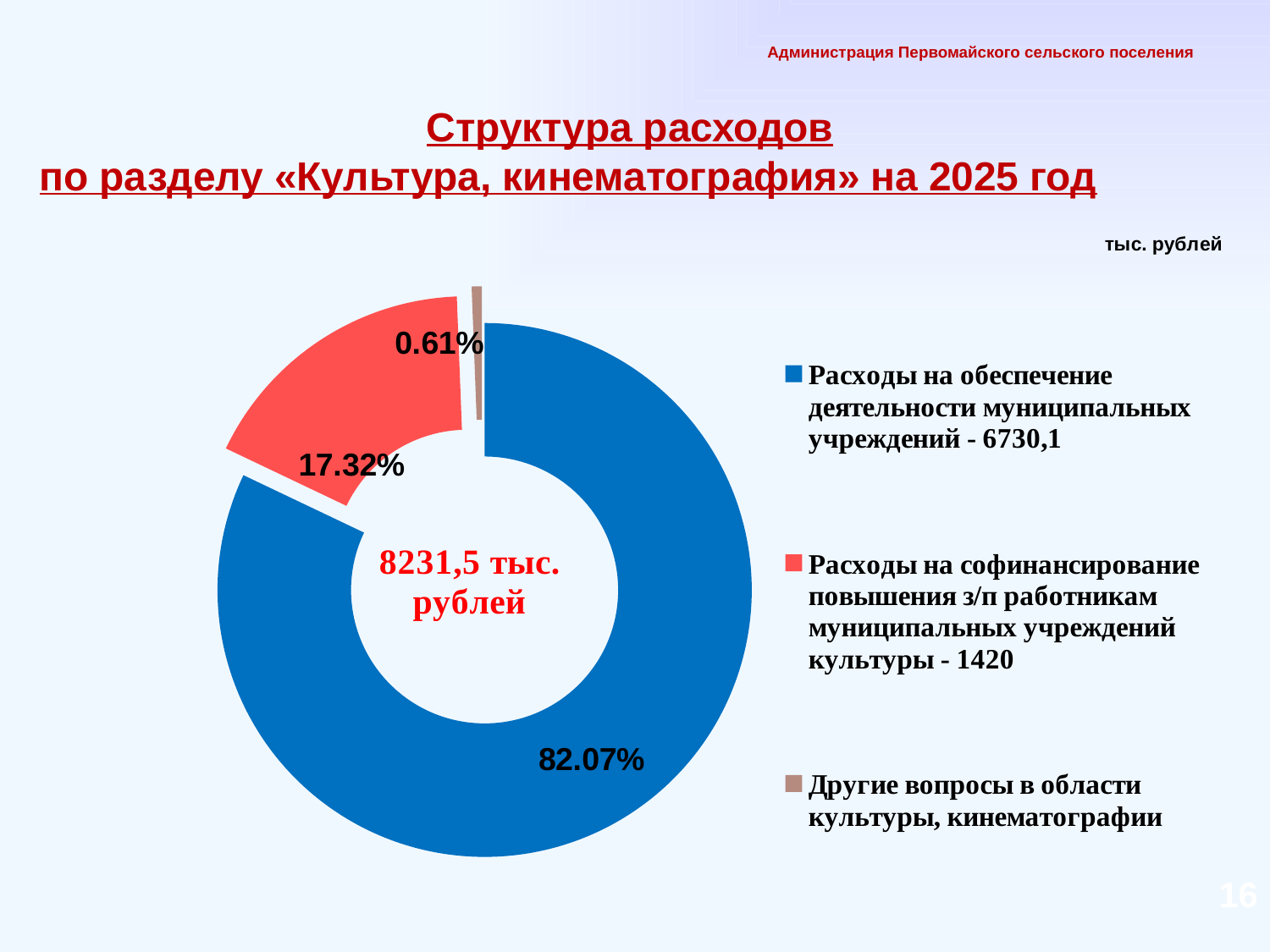
What share of the chart does the slice for «Другие вопросы в области культуры, кинематографии» represent? 0.61% What total amount is shown in the centre of the chart? 8231,5 тыс. рублей How many categories are shown in the chart? 3 Which category has the largest slice in the chart? Расходы на обеспечение деятельности муниципальных учреждений What is the difference in percentage points between the largest slice (82.07%) and the slice for «Расходы на софинансирование повышения з/п работникам муниципальных учреждений культуры» (17.32%)? 64.75 percentage points What share of the chart does the slice for «Расходы на софинансирование повышения з/п работникам муниципальных учреждений культуры» represent? 17.32% What amount is given in the legend for «Расходы на софинансирование повышения з/п работникам муниципальных учреждений культуры»? 1420 What share of the chart does the slice for «Расходы на обеспечение деятельности муниципальных учреждений» represent? 82.07% What kind of chart is shown on the slide? Doughnut (pie) chart What amount is given in the legend for «Расходы на обеспечение деятельности муниципальных учреждений»? 6730,1 Which category has the smallest slice in the chart? Другие вопросы в области культуры, кинематографии Which slice is larger: «Расходы на софинансирование повышения з/п работникам муниципальных учреждений культуры» or «Другие вопросы в области культуры, кинематографии»? Расходы на софинансирование повышения з/п работникам муниципальных учреждений культуры